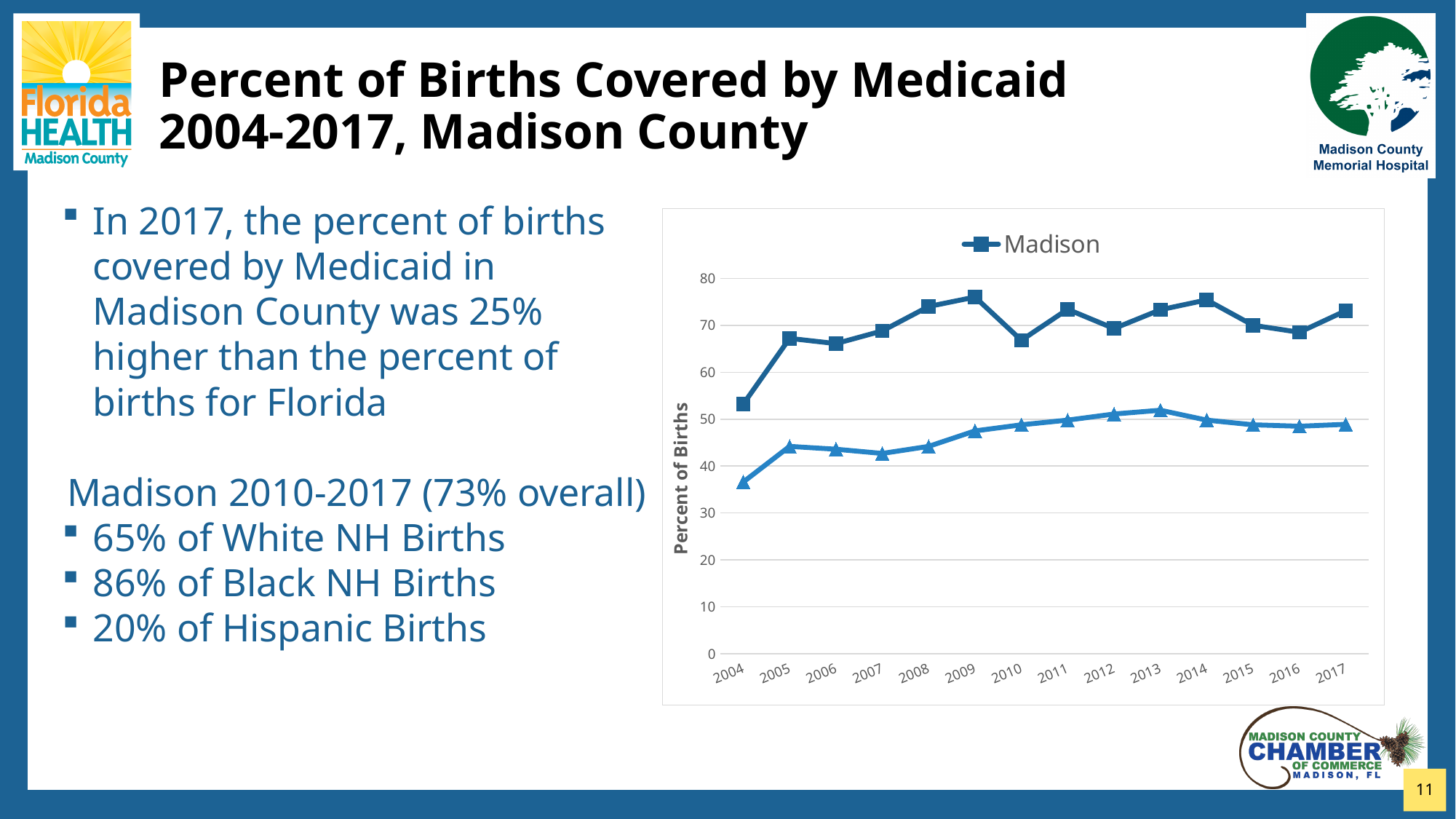
Does the Madison series rise or fall from 2004 to 2005? rise How many series does the chart's legend list? 1 Is the Madison value for 2009 greater or less than 70? greater Is the value of the lower (triangle-marker) line for 2004 greater or less than 40? less What is the label of the chart's y axis? Percent of Births How many years are plotted along the x axis of the chart? 14 In which year does the Madison series have its lowest value? 2004 What kind of chart is shown on the slide? line chart Is the Madison value for 2004 greater or less than 50? greater What is the name of the series shown in the chart's legend? Madison In which year does the Madison series reach its highest value? 2009